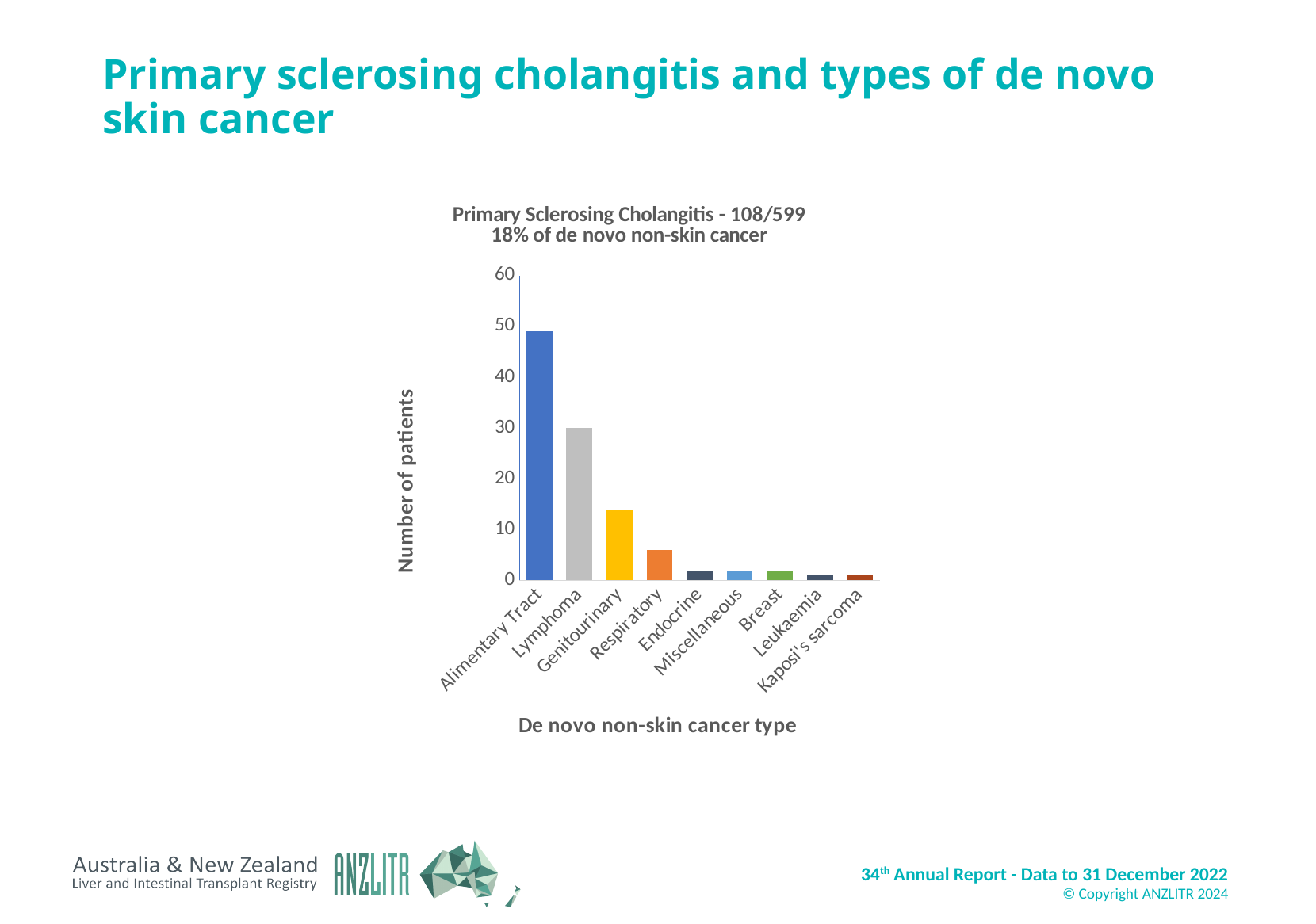
What is the label of the y axis? Number of patients Which has more patients, Respiratory or Breast? Respiratory How many cancer type categories are shown on the x axis? 9 Is the value for Respiratory greater or less than 10? less Is the value for Lymphoma greater or less than 40? less Which de novo non-skin cancer type has the highest number of patients? Alimentary Tract Do the values generally rise or fall moving from left to right along the x axis? fall Is the value for Genitourinary greater or less than 10? greater Which has more patients, Lymphoma or Genitourinary? Lymphoma What percentage of de novo non-skin cancer does the chart title attribute to Primary Sclerosing Cholangitis? 18% What kind of chart is shown on the slide? bar chart